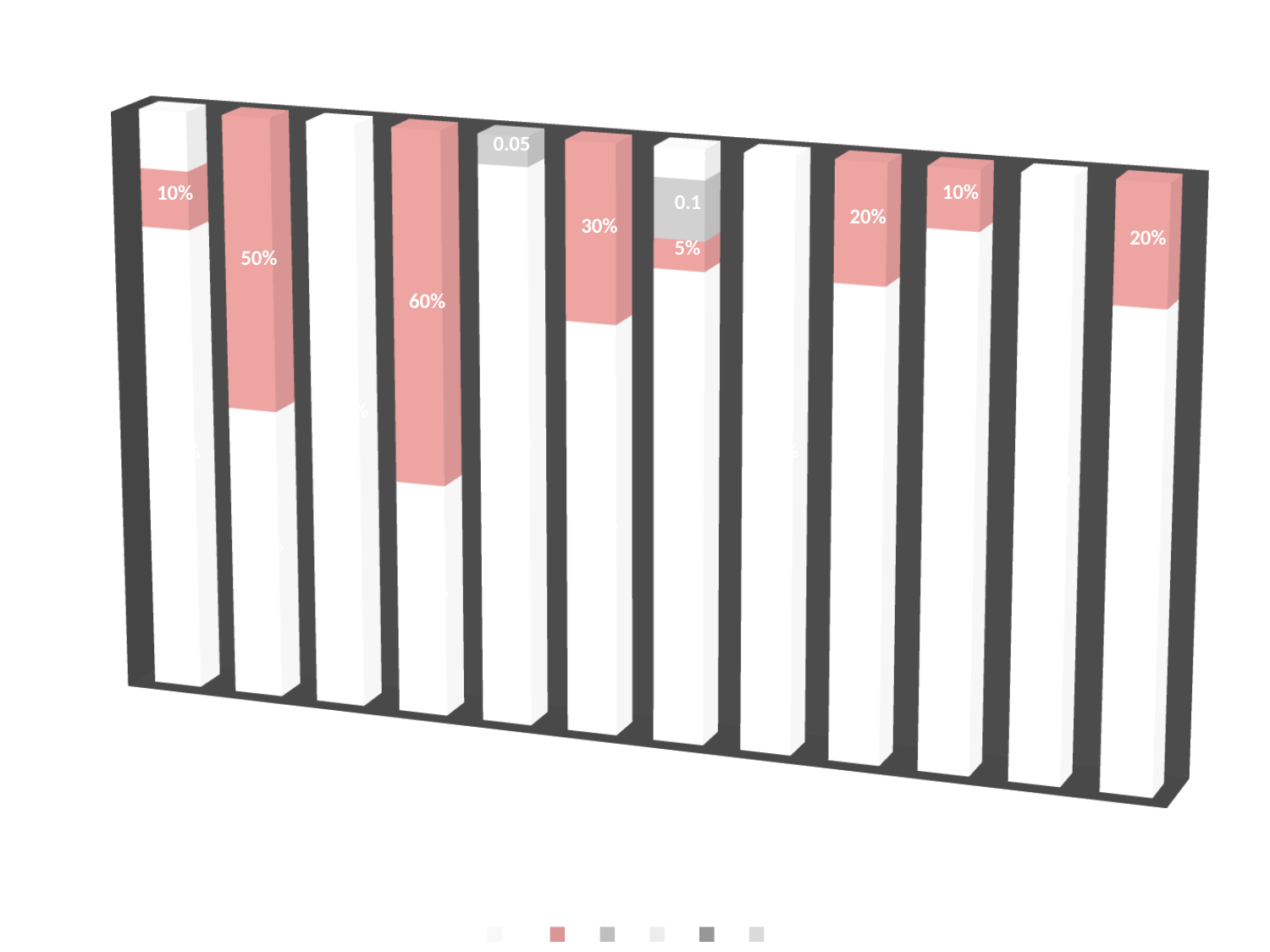
How many series does the legend list? 6 What value is labelled on the grey segment at the top of the fifth bar from the left? 0.05 What is the value labelled on the pink segment of the sixth bar from the left? 30% What is the difference between the pink segment of the fourth bar (60%) and the pink segment of the second bar (50%)? 10% What is the value labelled on the pink segment of the fourth bar from the left? 60% Which is larger, the pink segment of the second bar or the pink segment of the sixth bar? the second bar Which bar has the largest labelled pink segment? the fourth bar from the left (60%) What is the value labelled on the pink segment of the second bar from the left? 50% What type of chart is shown on the slide? bar chart What is the value labelled on the pink segment of the seventh bar from the left? 5% How many bars are plotted in the chart? 12 What value is labelled on the grey segment of the seventh bar from the left? 0.1